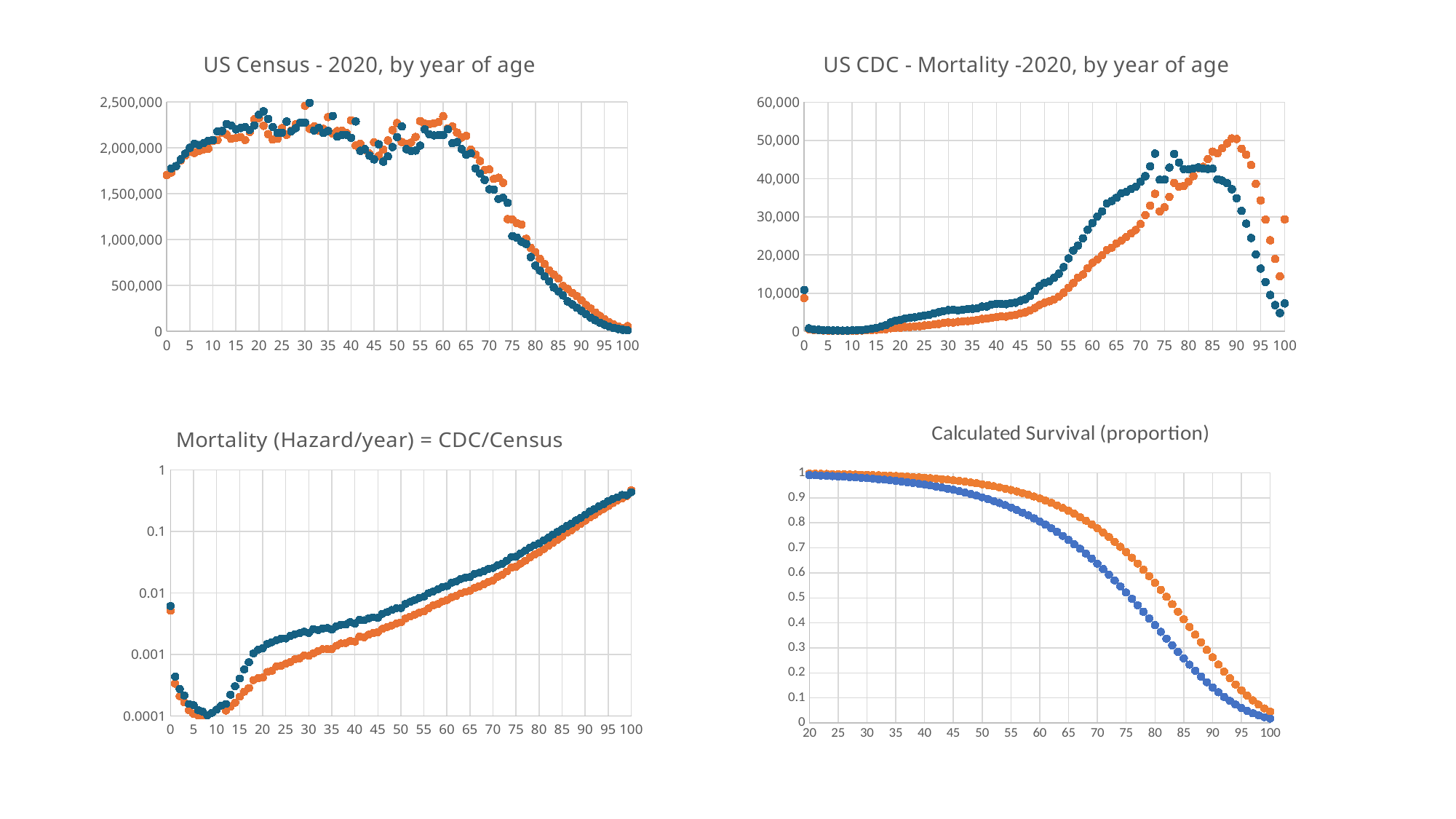
In the 'Calculated Survival (proportion)' chart, is the blue series value at age 80 greater or less than 0.5? less What is the title of the bottom-left chart? Mortality (Hazard/year) = CDC/Census What kind of chart is 'US Census - 2020, by year of age'? scatter chart In the 'Mortality (Hazard/year) = CDC/Census' chart, do the values rise or fall from age 20 to age 100? rise In the 'US Census - 2020, by year of age' chart, is the value at age 100 greater or less than 500,000? less In the 'US CDC - Mortality -2020, by year of age' chart, is the orange series value at age 90 greater or less than 40,000? greater In the 'Calculated Survival (proportion)' chart, which series is higher at age 70, blue or orange? orange How many charts are shown on the slide? 4 In the 'Calculated Survival (proportion)' chart, do the values rise or fall as age increases along the x axis? fall